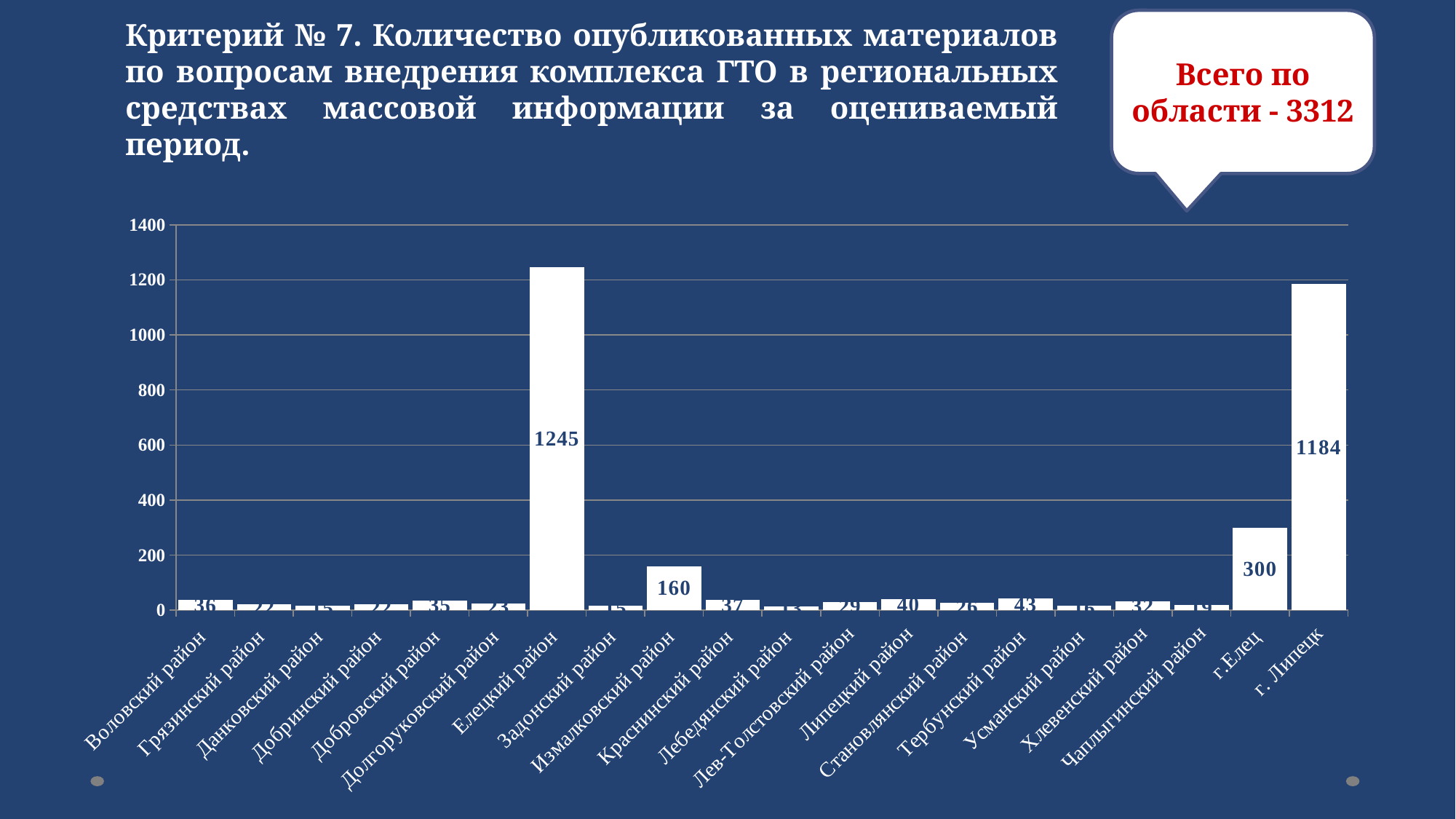
Is the value for г.Елец greater or less than 400? less What is the value for г. Липецк? 1184 How many districts/cities are shown on the x axis? 20 Which district has the highest number of published materials? Елецкий район What kind of chart is shown on the slide? bar chart What is the difference between the values for Елецкий район and г. Липецк? 61 What is the difference between the values for г.Елец and Измалковский район? 140 What is the value for Елецкий район? 1245 What total for the whole region is stated in the callout on the slide? 3312 Which is larger, the value for Елецкий район or the value for г. Липецк? Елецкий район What is the value for Измалковский район? 160 What is the value for г.Елец? 300